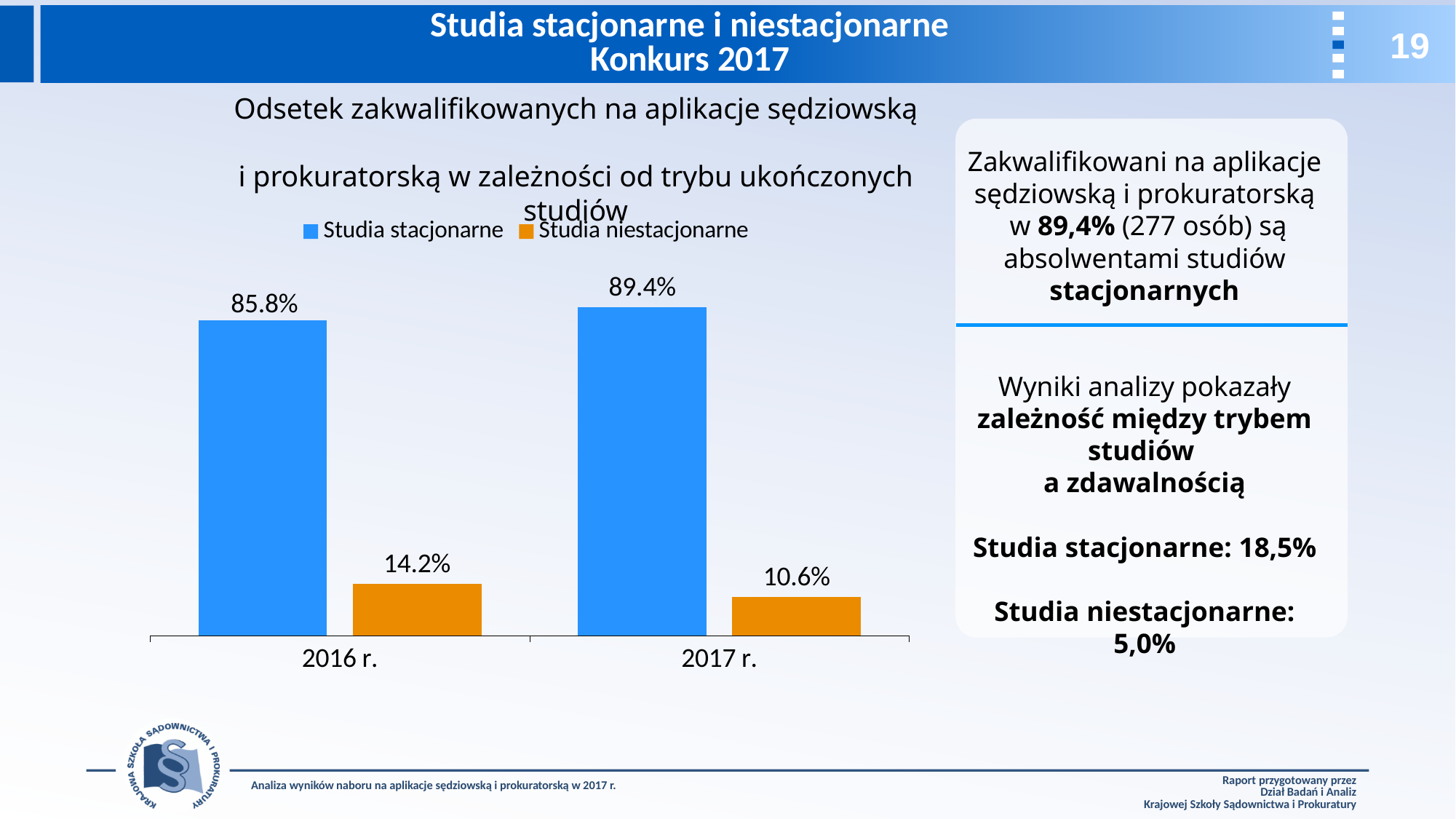
What is the value for Studia niestacjonarne in 2017 r.? 10.6% What is the value for Studia stacjonarne in 2017 r.? 89.4% How many categories are shown on the x axis? 2 Which year has the lower value for Studia niestacjonarne? 2017 r. How many series does the legend list? 2 What is the difference between Studia stacjonarne and Studia niestacjonarne in 2017 r.? 78.8% Which year has the higher value for Studia stacjonarne? 2017 r. What is the difference between the Studia stacjonarne values for 2017 r. and 2016 r.? 3.6% What is the value for Studia stacjonarne in 2016 r.? 85.8% What kind of chart is shown on the slide? Bar chart Which is larger in 2016 r.: Studia stacjonarne or Studia niestacjonarne? Studia stacjonarne What is the value for Studia niestacjonarne in 2016 r.? 14.2%